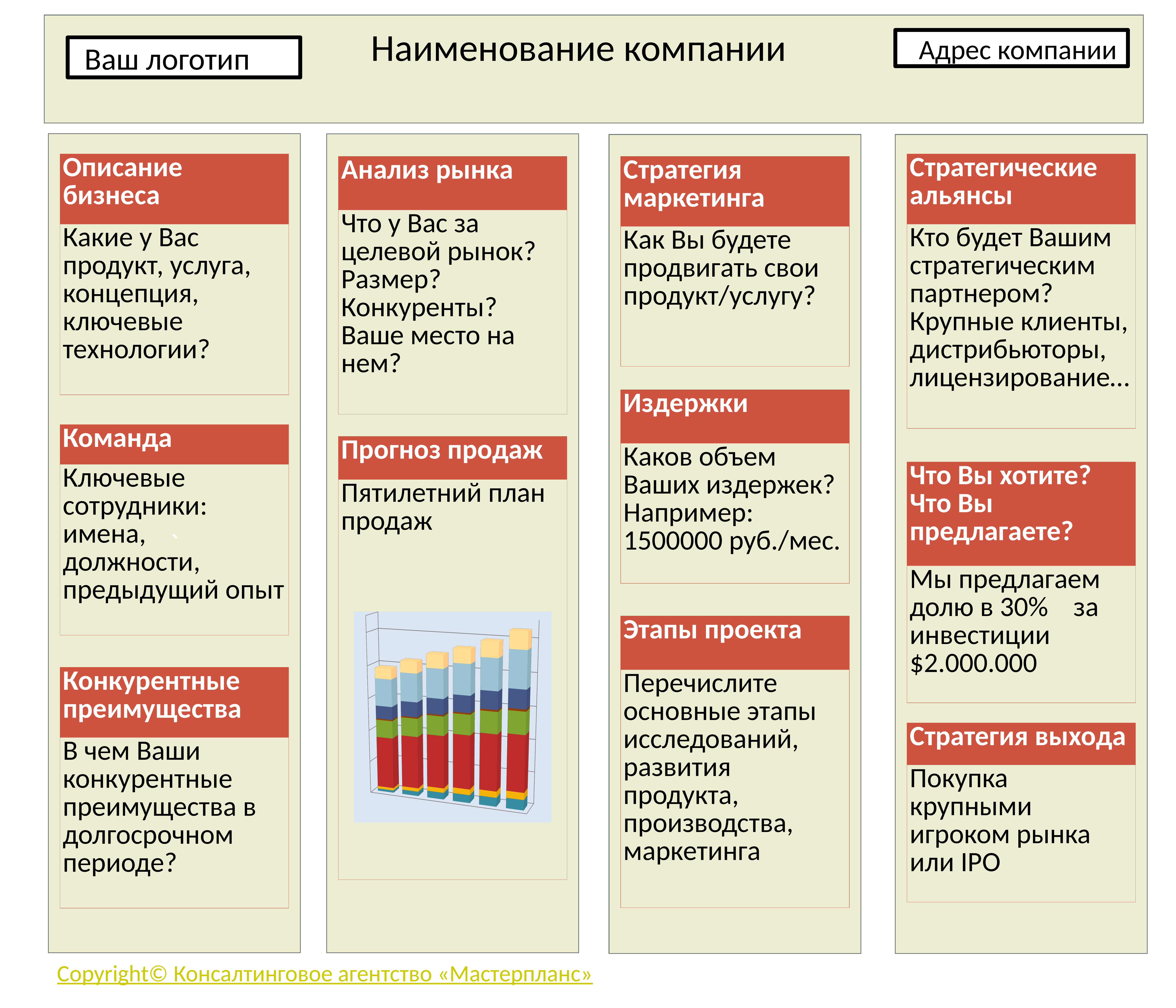
What kind of chart is shown in the "Прогноз продаж" section? Stacked bar chart Which bar in the "Прогноз продаж" chart is the tallest, the leftmost or the rightmost? The rightmost Do the bar heights in the "Прогноз продаж" chart rise or fall from left to right? Rise How many bars does the chart in the "Прогноз продаж" section contain? 6 Under which section heading does the chart on the slide appear? Прогноз продаж Which bar in the "Прогноз продаж" chart is the shortest? The leftmost Is the leftmost bar or the rightmost bar taller in the "Прогноз продаж" chart? The rightmost bar Does the chart on the slide display a legend? No